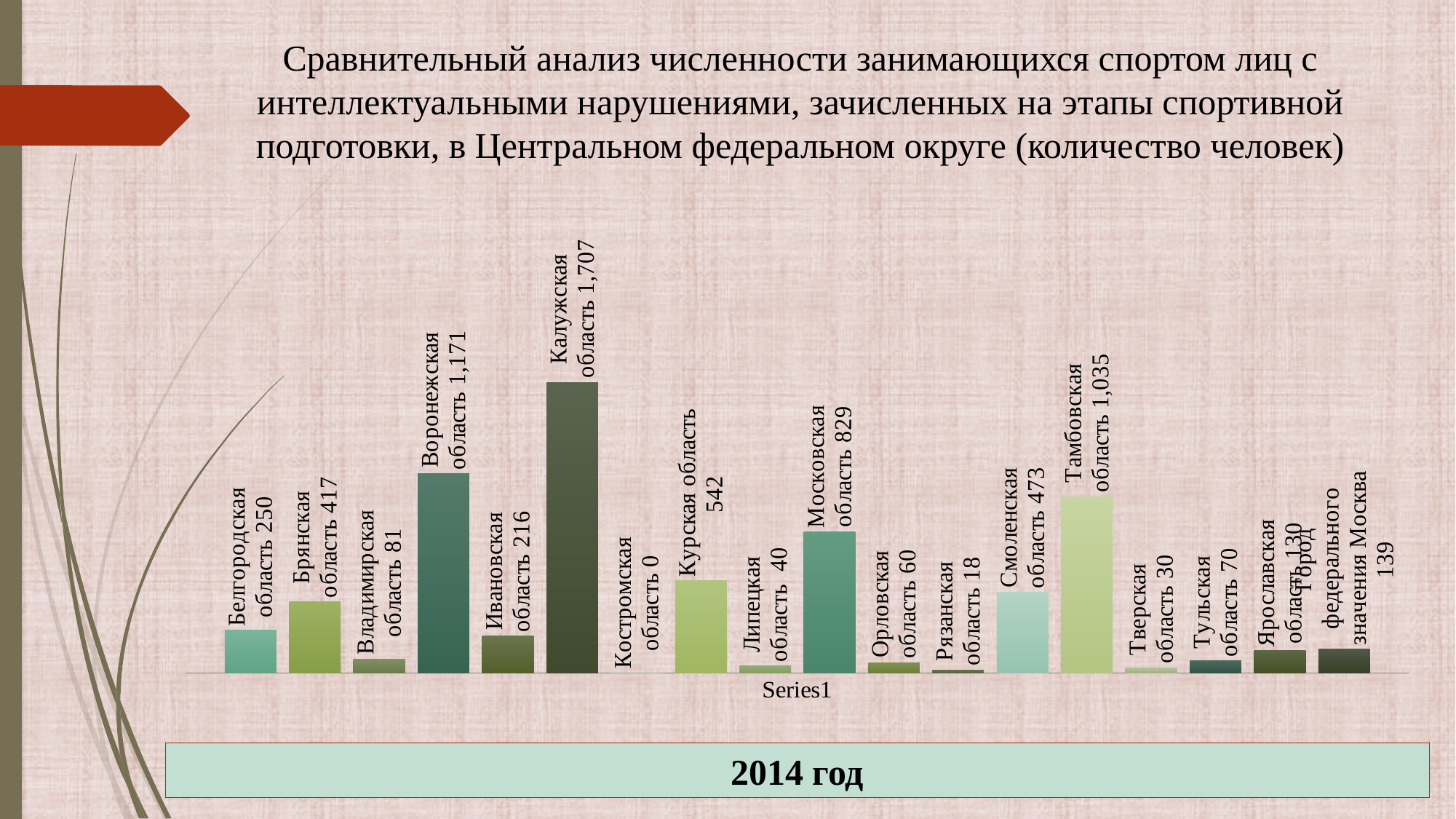
What is the difference between the values for Московская область and Курская область? 287 What is the value for Город федерального значения Москва? 139 What is the value for Московская область? 829 Which region has the highest value? Калужская область What year is indicated in the box below the chart? 2014 год How many regions (categories) are shown in the chart? 18 What is the value for Тамбовская область? 1,035 Which is larger, the value for Брянская область or the value for Смоленская область? Смоленская область What type of chart is shown on the slide? bar chart What is the difference between the values for Калужская область and Воронежская область? 536 Which region has the lowest value? Костромская область What is the value for Калужская область? 1,707